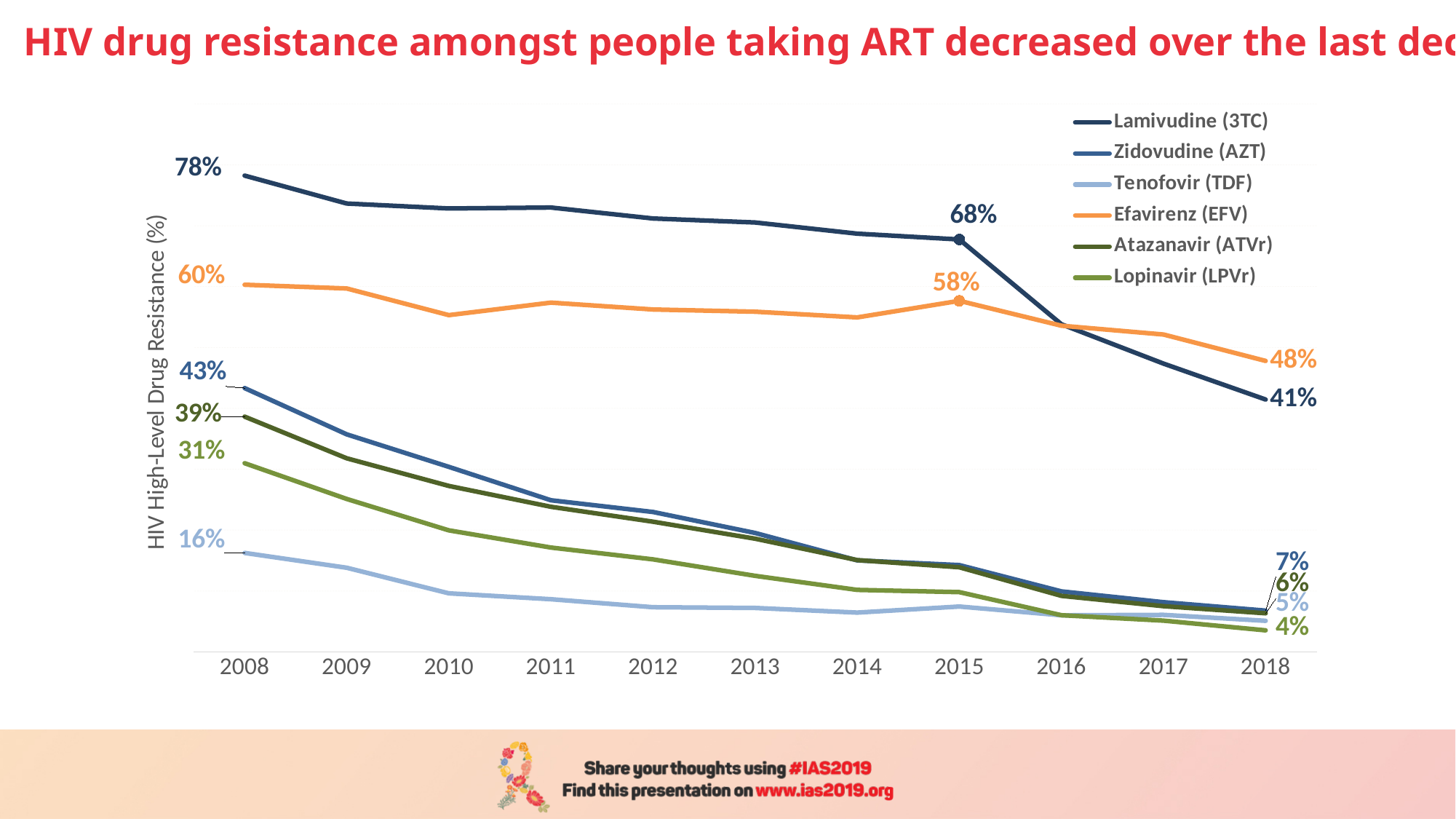
Which drug had the lowest resistance level in 2018? Lopinavir (LPVr) What was the value for Efavirenz (EFV) in 2018? 48% How many series does the legend list? 6 What was the value for Lamivudine (3TC) in 2015? 68% What type of chart is shown on the slide? line chart How many years are shown on the x axis? 11 By how many percentage points did Lamivudine (3TC) resistance fall from 2008 to 2018? 37 What was the value for Tenofovir (TDF) in 2008? 16% Does the Zidovudine (AZT) line rise or fall from 2008 to 2018? fall In 2018, which was higher: Efavirenz (EFV) or Lamivudine (3TC)? Efavirenz (EFV) Which drug had the highest resistance level in 2008? Lamivudine (3TC) What was the HIV high-level drug resistance for Lamivudine (3TC) in 2008? 78%